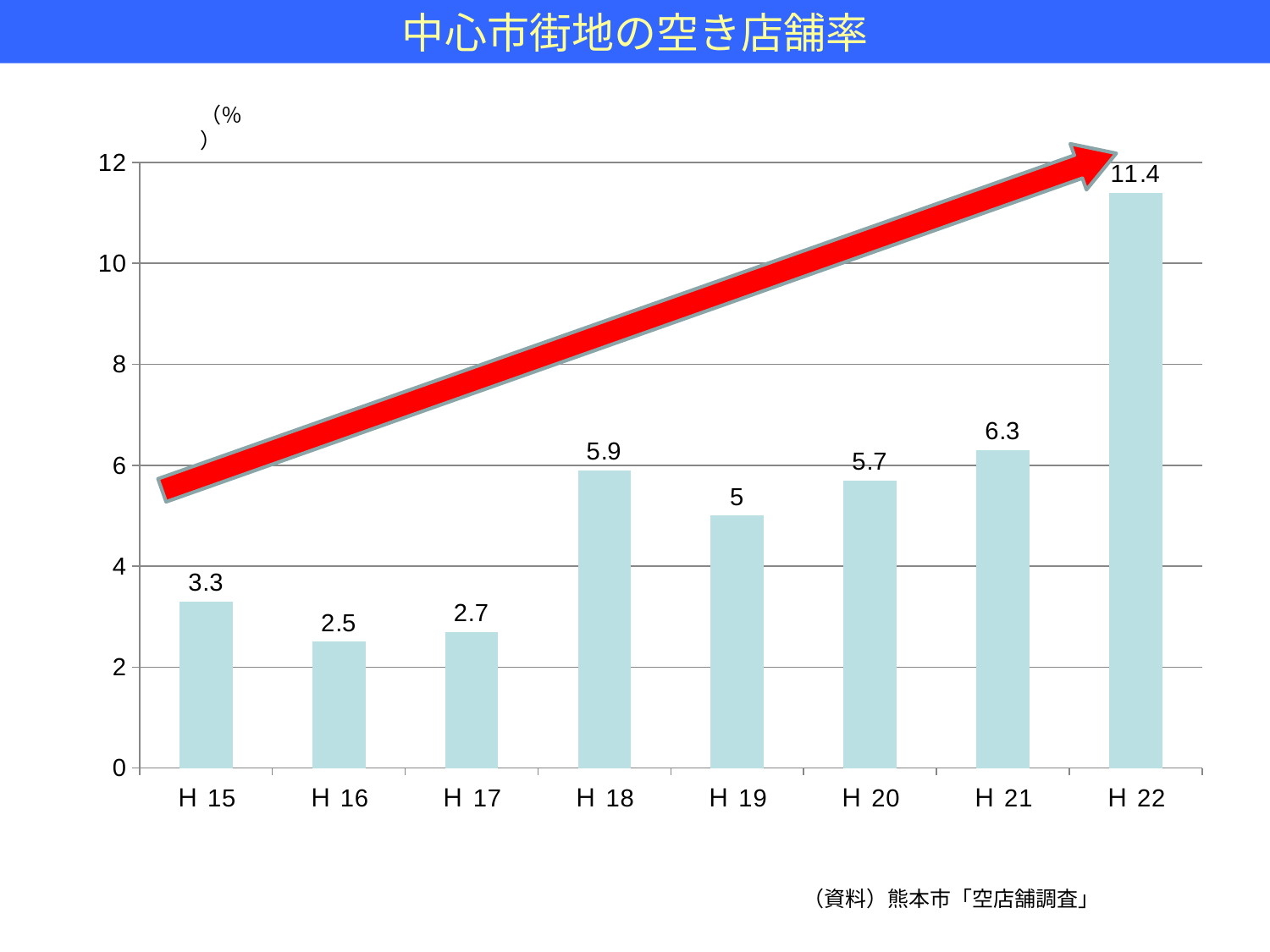
Which year has the lowest vacancy rate? H 16 Which year has the highest vacancy rate? H 22 How many years are shown on the x axis? 8 What is the value shown for H 16? 2.5 What is the value shown for H 22? 11.4 Which is larger, the value for H 20 or the value for H 21? H 21 What is the difference between the values for H 18 and H 19? 0.9 What is the title of the chart? 中心市街地の空き店舗率 What is the vacancy rate for H 18? 5.9 What is the difference between the values for H 22 and H 21? 5.1 What kind of chart is shown on the slide? bar chart Is the value for H 19 greater or less than 4? greater